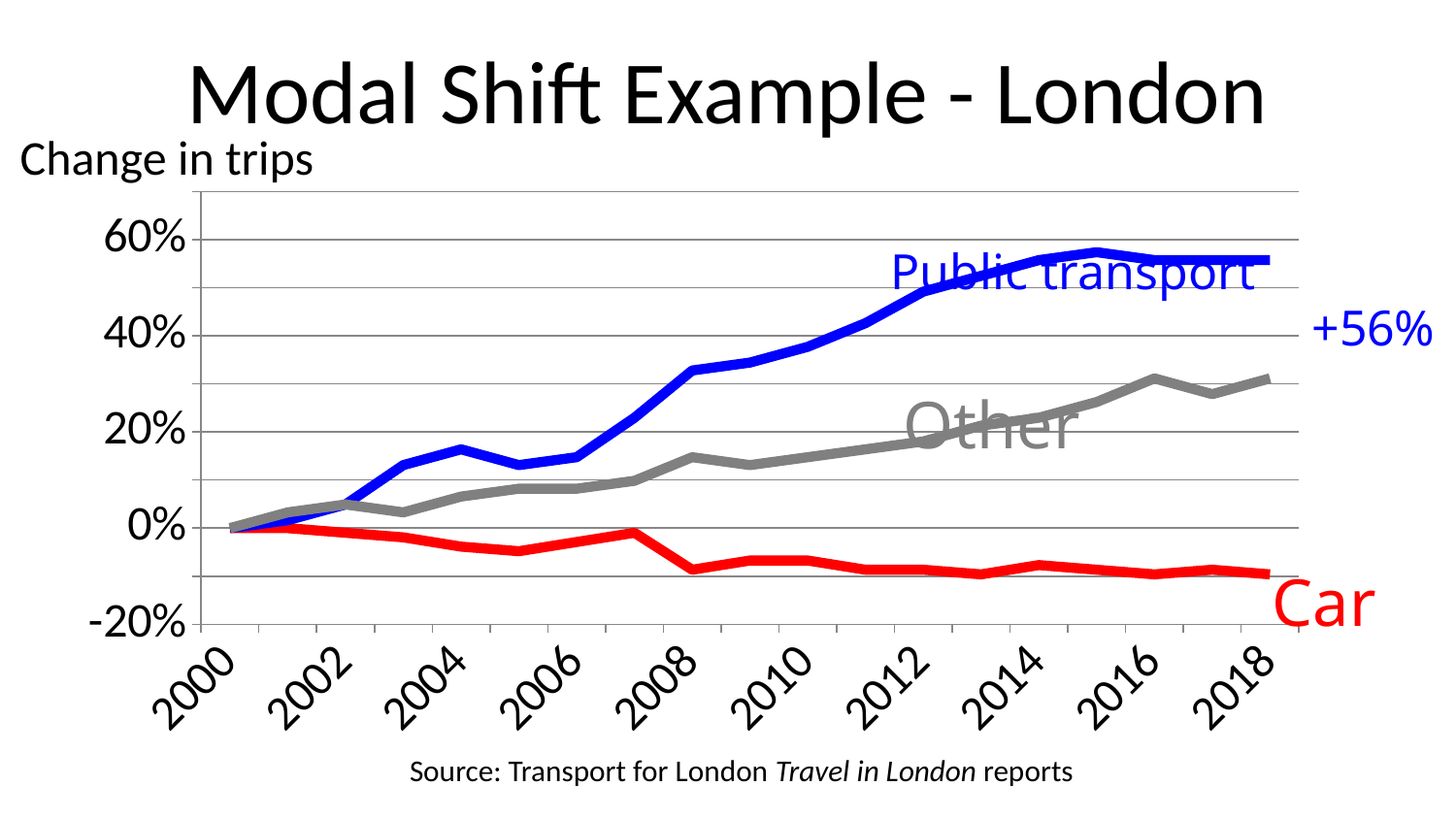
Does the Public transport line rise or fall from 2000 to 2018? Rise Does the Car line rise or fall from 2000 to 2018? Fall Is the value for Car in 2018 greater or less than 0%? less What is the change in trips for Public transport shown at the end of the series in 2018? +56% How many series are plotted on the chart? 3 What type of chart is shown on the slide? Line chart Which series has the lowest value in 2018? Car Is the value for Other in 2018 greater or less than 20%? greater In 2010, which is larger: the value for Public transport or the value for Other? Public transport Which series has the highest value in 2018? Public transport Is the value for Public transport in 2008 greater or less than 20%? greater What colour is the Car line? Red